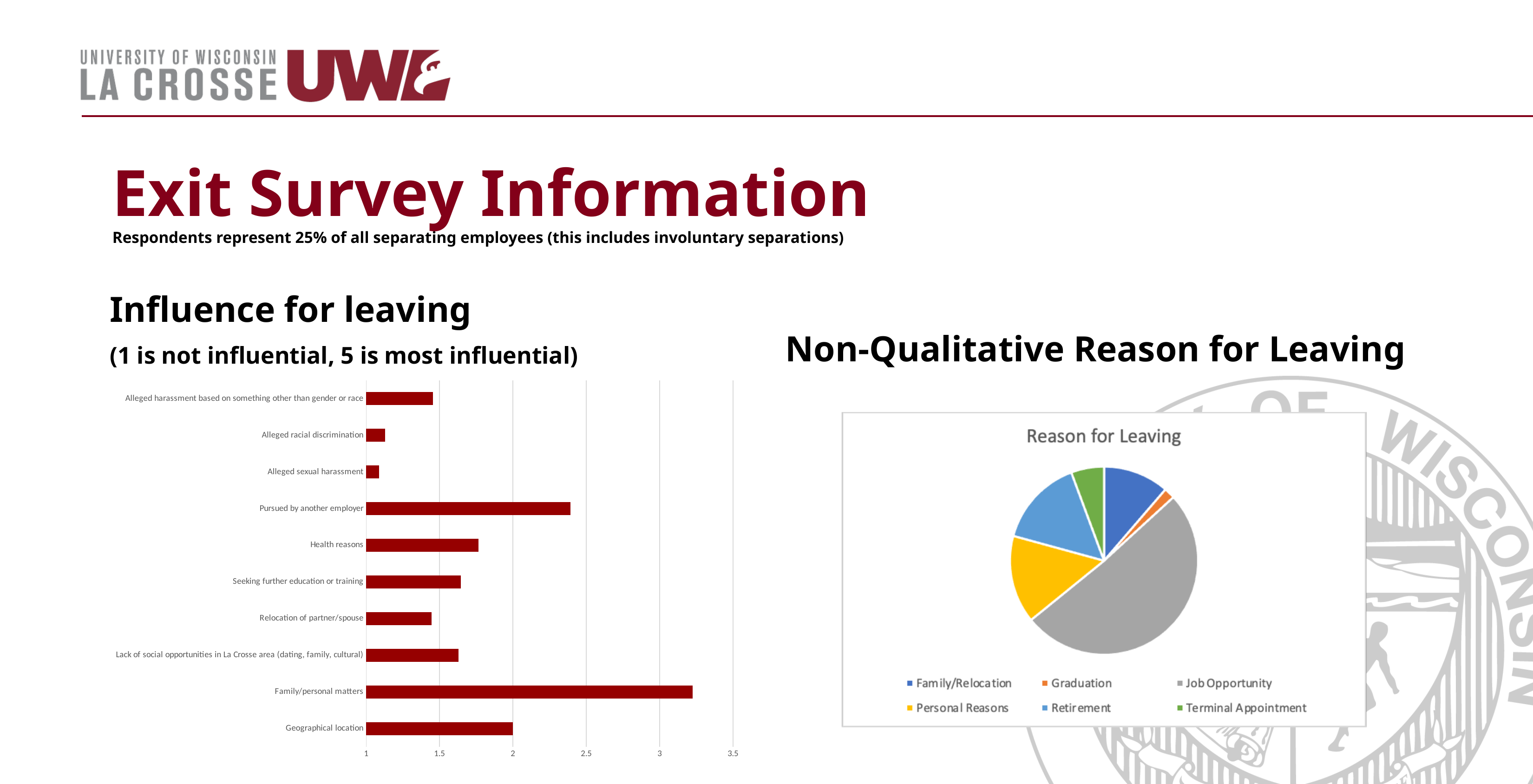
In the 'Influence for leaving' chart, is the value for 'Health reasons' greater or less than 2? less In the 'Reason for Leaving' pie chart, which reason has the smallest slice? Graduation How many entries does the legend of the 'Reason for Leaving' pie chart list? 6 What kind of chart is the 'Influence for leaving' chart on the left? bar chart In the 'Influence for leaving' chart, is the value for 'Pursued by another employer' greater or less than 2? greater In the 'Reason for Leaving' pie chart, which reason has the largest slice? Job Opportunity In the 'Influence for leaving' chart, which category has the highest value? Family/personal matters In the 'Influence for leaving' chart, is the value for 'Alleged racial discrimination' greater or less than 1.5? less What kind of chart is the 'Reason for Leaving' chart on the right? pie chart How many categories are shown in the 'Influence for leaving' bar chart? 10 In the 'Influence for leaving' chart, which is larger: 'Pursued by another employer' or 'Health reasons'? Pursued by another employer